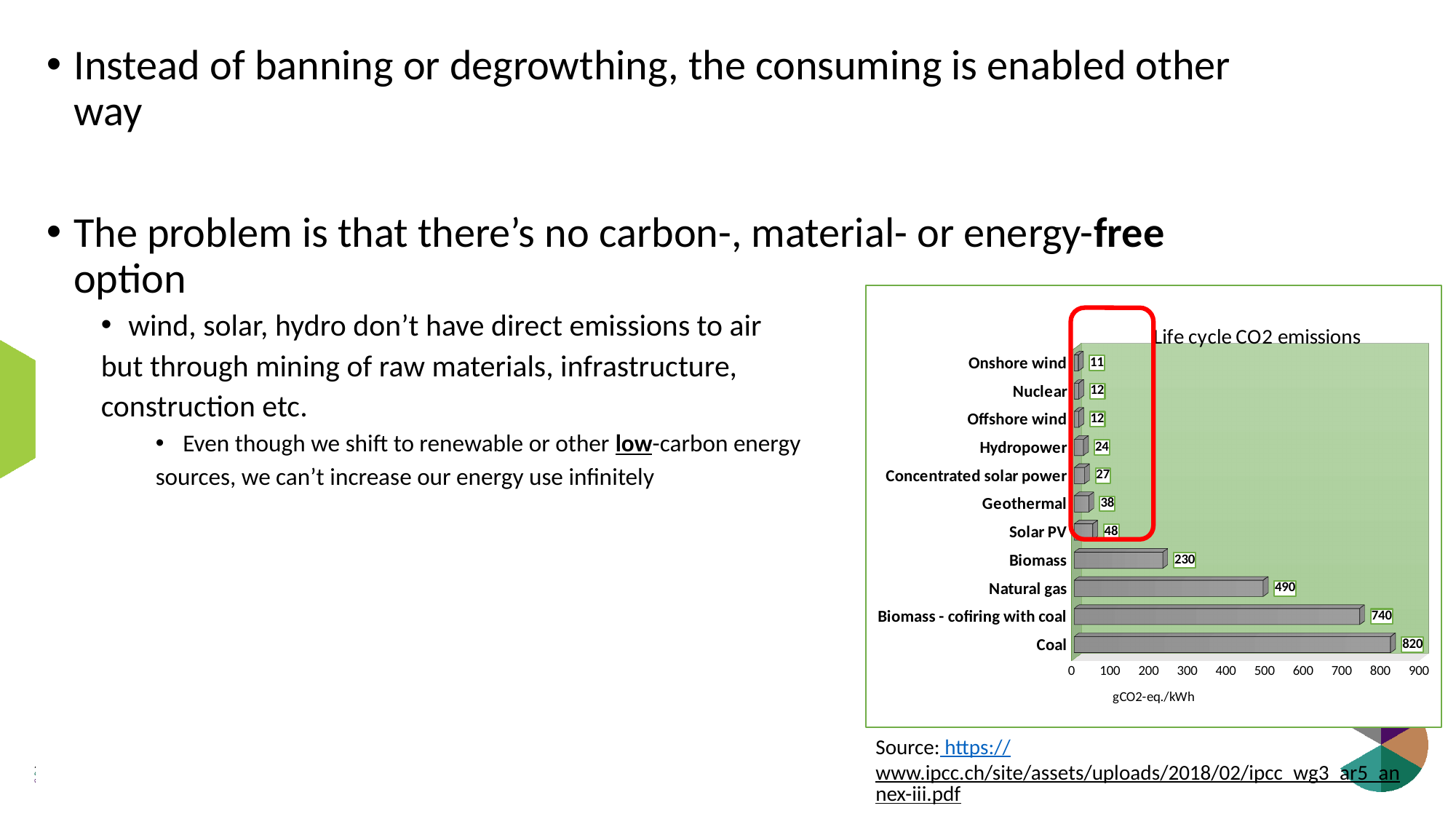
Which energy source has the highest life cycle CO2 emissions? Coal What is the value shown for Solar PV? 48 What is the value shown for Natural gas? 490 How many energy sources are shown in the chart? 11 What kind of chart is shown on the slide? Bar chart What is the difference between the values for Natural gas and Biomass? 260 What is the difference between the values for Coal and Biomass - cofiring with coal? 80 Which has a larger value, Geothermal or Concentrated solar power? Geothermal Which energy source has the lowest life cycle CO2 emissions? Onshore wind What is the value shown for Hydropower? 24 What is the life cycle CO2 emissions value for Coal? 820 What unit is shown on the x axis of the chart? gCO2-eq./kWh